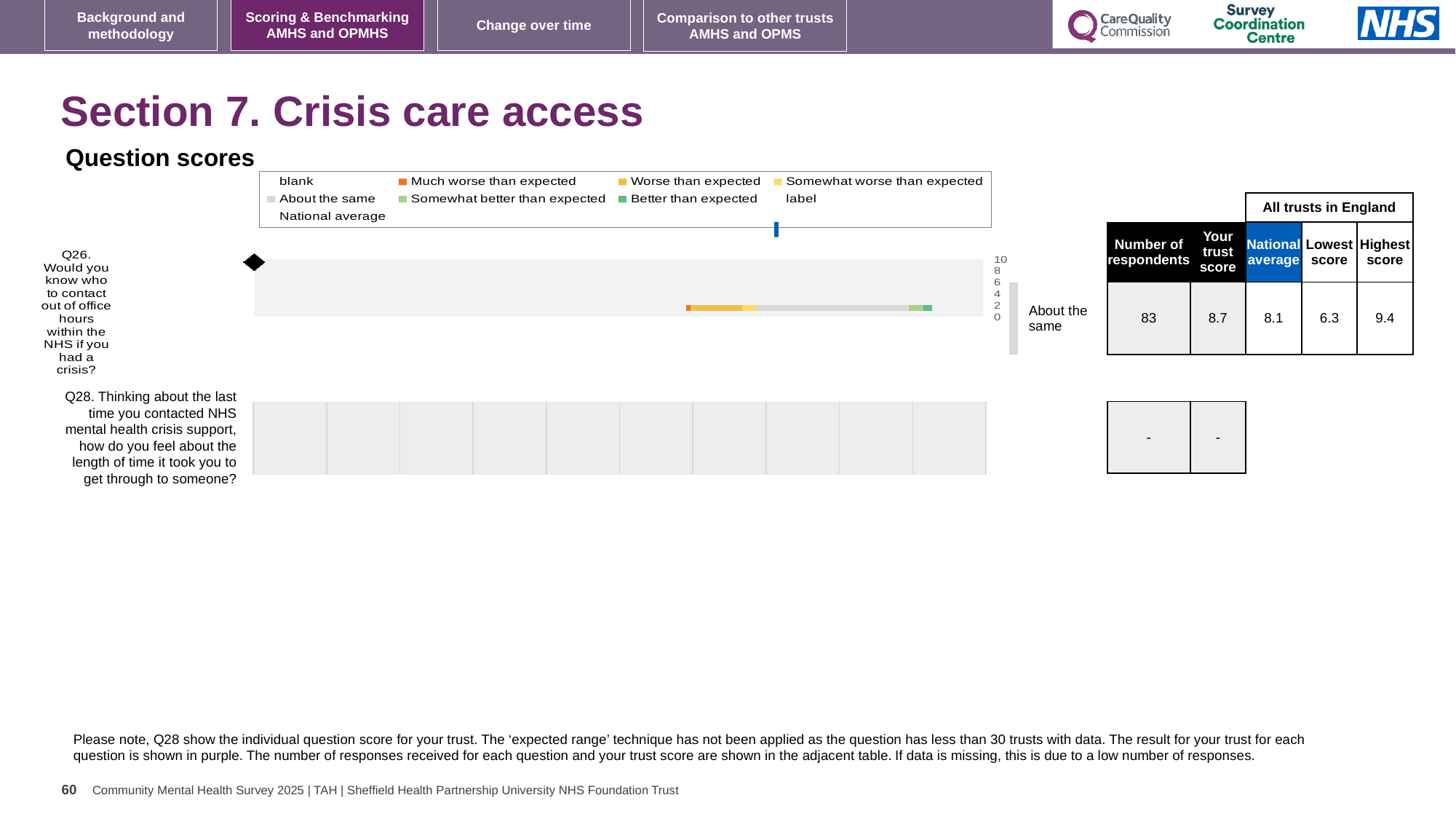
By how much does the trust score for Q26 exceed the national average? 0.6 What is the highest score among all trusts in England for Q26? 9.4 What is shown as the trust score for Q28 in the table? - What is the lowest score among all trusts in England for Q26? 6.3 What is the difference between the highest and lowest scores across all trusts in England for Q26? 3.1 Which expected-range category is the trust's Q26 result placed in? About the same What is the national average score for Q26? 8.1 How many respondents answered Q26? 83 Which is larger for Q26: the trust score or the national average? Trust score What type of chart is used for the Question scores? Bar chart How many questions are plotted in the Question scores chart? 2 What is the trust score for Q26 (Would you know who to contact out of office hours within the NHS if you had a crisis?)? 8.7